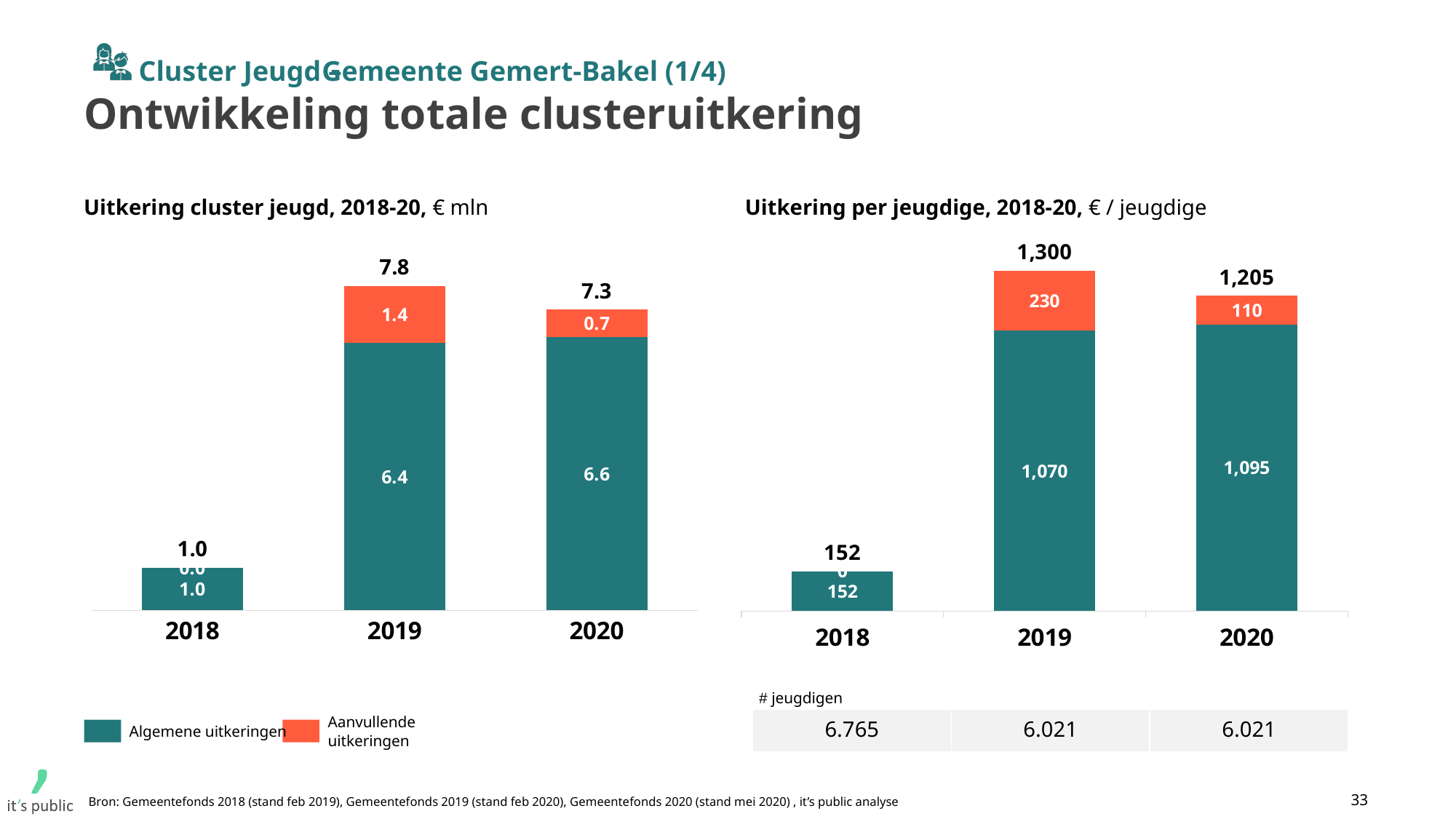
In the chart 'Uitkering cluster jeugd, 2018-20', what is the difference between the totals for 2019 and 2020? 0.5 In the chart 'Uitkering per jeugdige, 2018-20', what is the total value for 2020? 1,205 In the chart 'Uitkering per jeugdige, 2018-20', which year has the highest total? 2019 In the chart 'Uitkering per jeugdige, 2018-20', is Algemene uitkeringen larger in 2019 or in 2020? 2020 In the chart 'Uitkering cluster jeugd, 2018-20', which year has the lowest total? 2018 In the chart 'Uitkering per jeugdige, 2018-20', what is the value of Algemene uitkeringen in 2019? 1,070 How many series does the legend list for the chart 'Uitkering cluster jeugd, 2018-20'? 2 In the chart 'Uitkering cluster jeugd, 2018-20', what is the value of Algemene uitkeringen in 2020? 6.6 What kind of chart is 'Uitkering per jeugdige, 2018-20'? Stacked bar chart In the chart 'Uitkering cluster jeugd, 2018-20', what is the total value for 2019? 7.8 In the chart 'Uitkering cluster jeugd, 2018-20', what is the value of Aanvullende uitkeringen in 2019? 1.4 In the chart 'Uitkering per jeugdige, 2018-20', what is the difference between Aanvullende uitkeringen in 2019 and 2020? 120